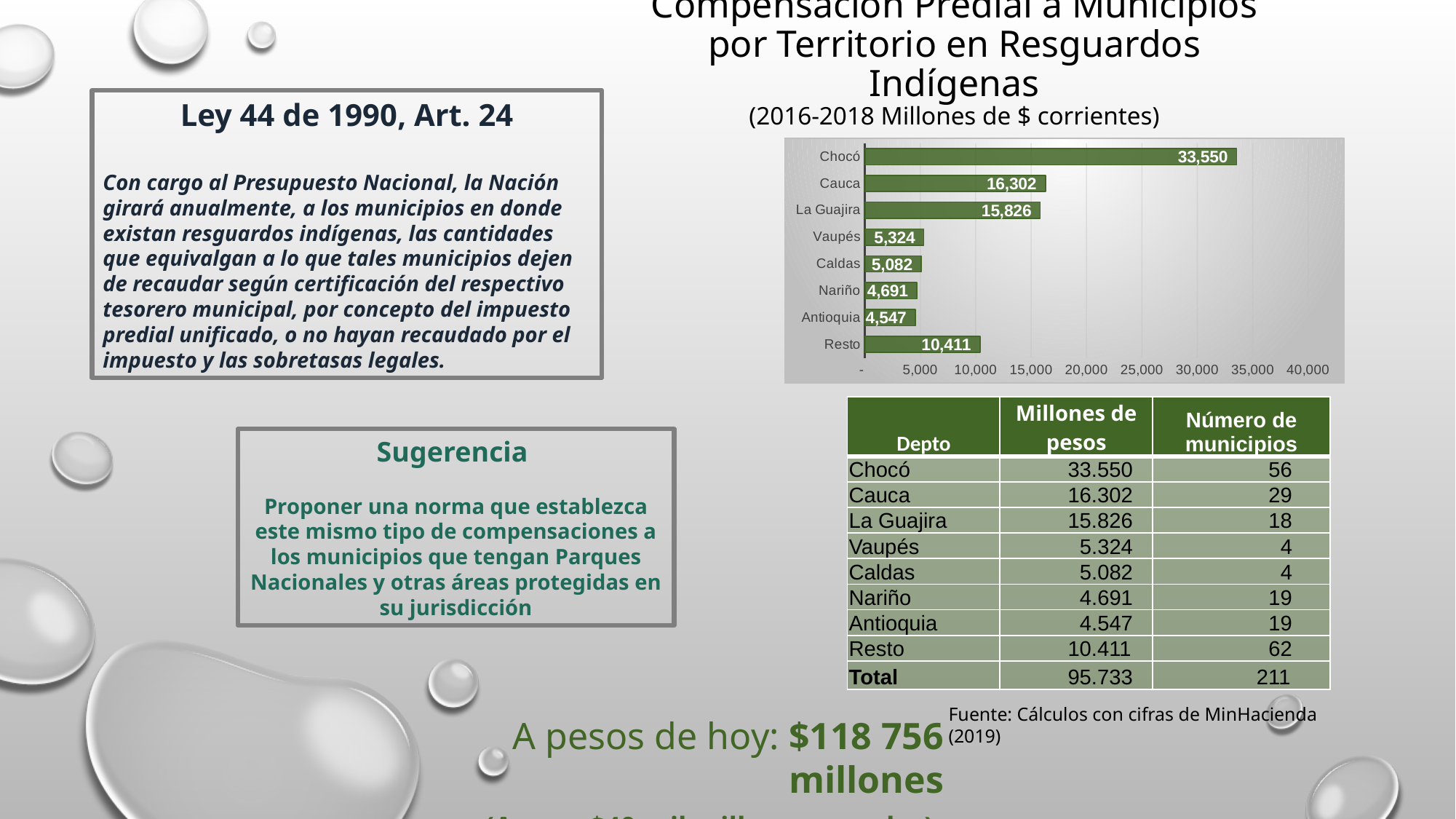
What kind of chart is shown on the slide? bar chart What is the value for La Guajira in the bar chart? 15,826 What is the value for Nariño in the bar chart? 4,691 Is the value for Cauca in the bar chart greater or less than 15,000? greater Which category has the lowest value in the bar chart? Antioquia What is the value for Chocó in the bar chart? 33,550 Which category has the highest value in the bar chart? Chocó What is the value for Resto in the bar chart? 10,411 Which has a larger value in the bar chart, Vaupés or Caldas? Vaupés What is the difference between the values for Chocó and Cauca in the bar chart? 17,248 How many categories are shown in the bar chart? 8 What period and unit does the chart subtitle indicate? 2016-2018 Millones de $ corrientes